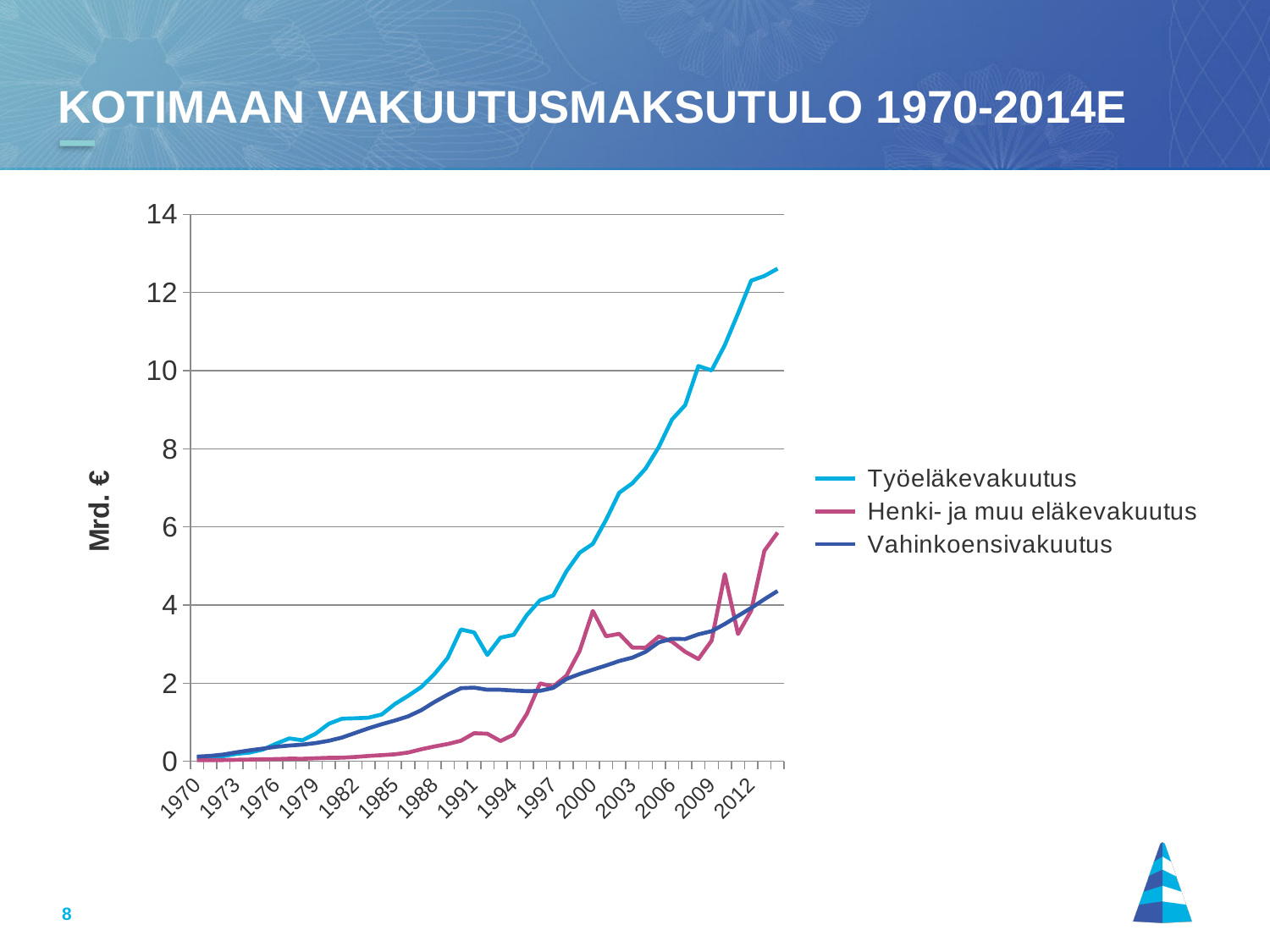
Which series has the lowest value in 1994? Henki- ja muu eläkevakuutus Is the value for Henki- ja muu eläkevakuutus in 2014E greater or less than 4? greater What is the title of the chart? KOTIMAAN VAKUUTUSMAKSUTULO 1970-2014E Which series has the highest value at the end of the period (2014E)? Työeläkevakuutus In 1991, which is larger: Vahinkoensivakuutus or Henki- ja muu eläkevakuutus? Vahinkoensivakuutus What kind of chart is shown on the slide? line chart In 2000, which is larger: Henki- ja muu eläkevakuutus or Vahinkoensivakuutus? Henki- ja muu eläkevakuutus Is the value for Työeläkevakuutus in 2006 greater or less than 6? greater Does the Työeläkevakuutus line generally rise or fall from 1970 to 2014E? rise How many series does the legend list? 3 Is the value for Henki- ja muu eläkevakuutus in 1994 greater or less than 2? less What is the label on the vertical axis? Mrd. €